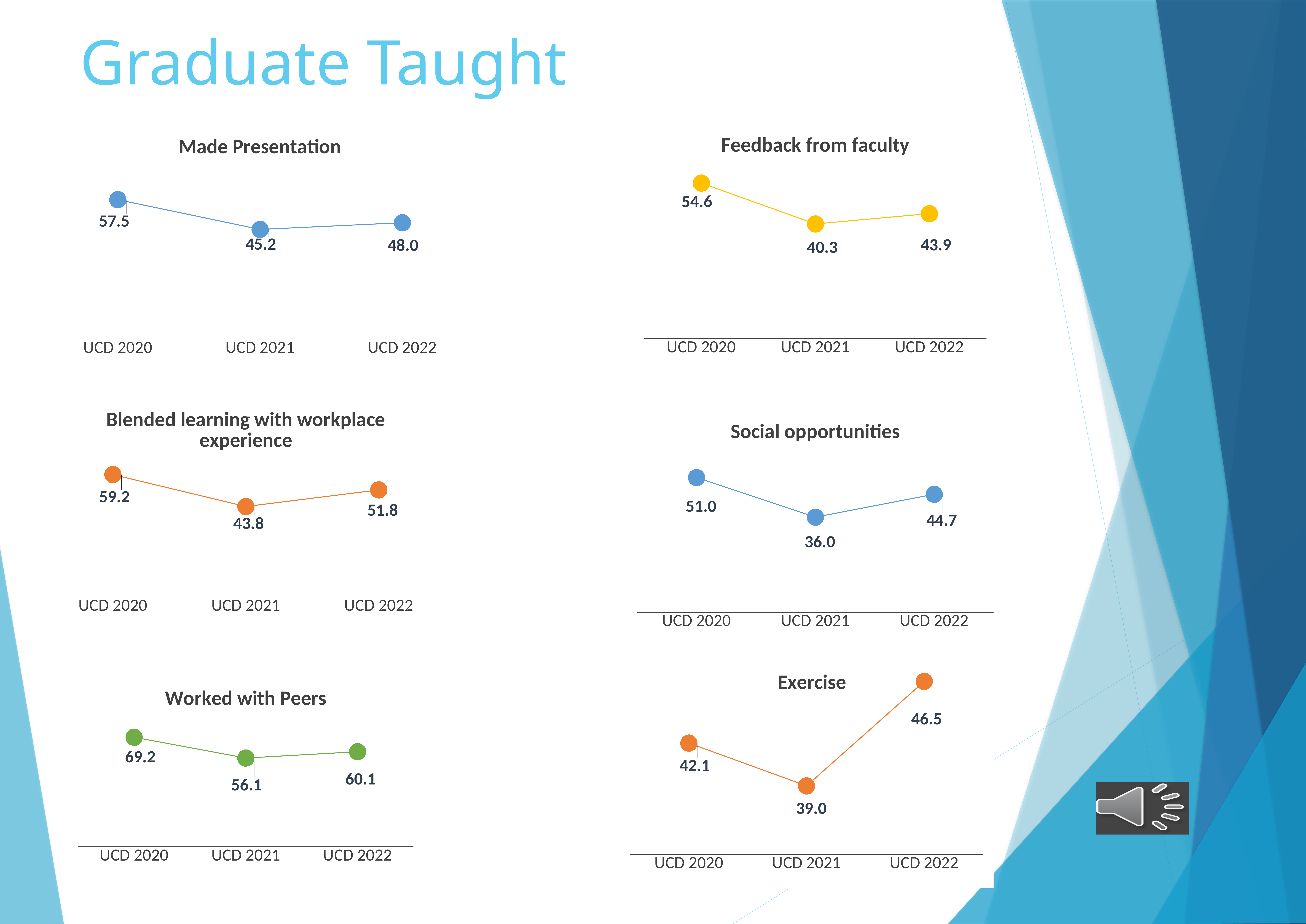
How many charts are shown on the slide? 6 In the 'Social opportunities' chart, which category has the lowest value? UCD 2021 In the 'Worked with Peers' chart, what is the value for UCD 2022? 60.1 In the 'Feedback from faculty' chart, what is the value for UCD 2022? 43.9 In the 'Worked with Peers' chart, what is the difference between the UCD 2020 and UCD 2021 values? 13.1 How many data points are plotted in the 'Social opportunities' chart? 3 In the 'Feedback from faculty' chart, which category has the highest value? UCD 2020 In the 'Made Presentation' chart, what is the value for UCD 2021? 45.2 In the 'Exercise' chart, do the values rise or fall from UCD 2021 to UCD 2022? Rise In the 'Blended learning with workplace experience' chart, what is the difference between the UCD 2020 and UCD 2021 values? 15.4 In the 'Exercise' chart, which is larger: the value for UCD 2020 or UCD 2022? UCD 2022 What kind of chart is the 'Exercise' chart? Line chart